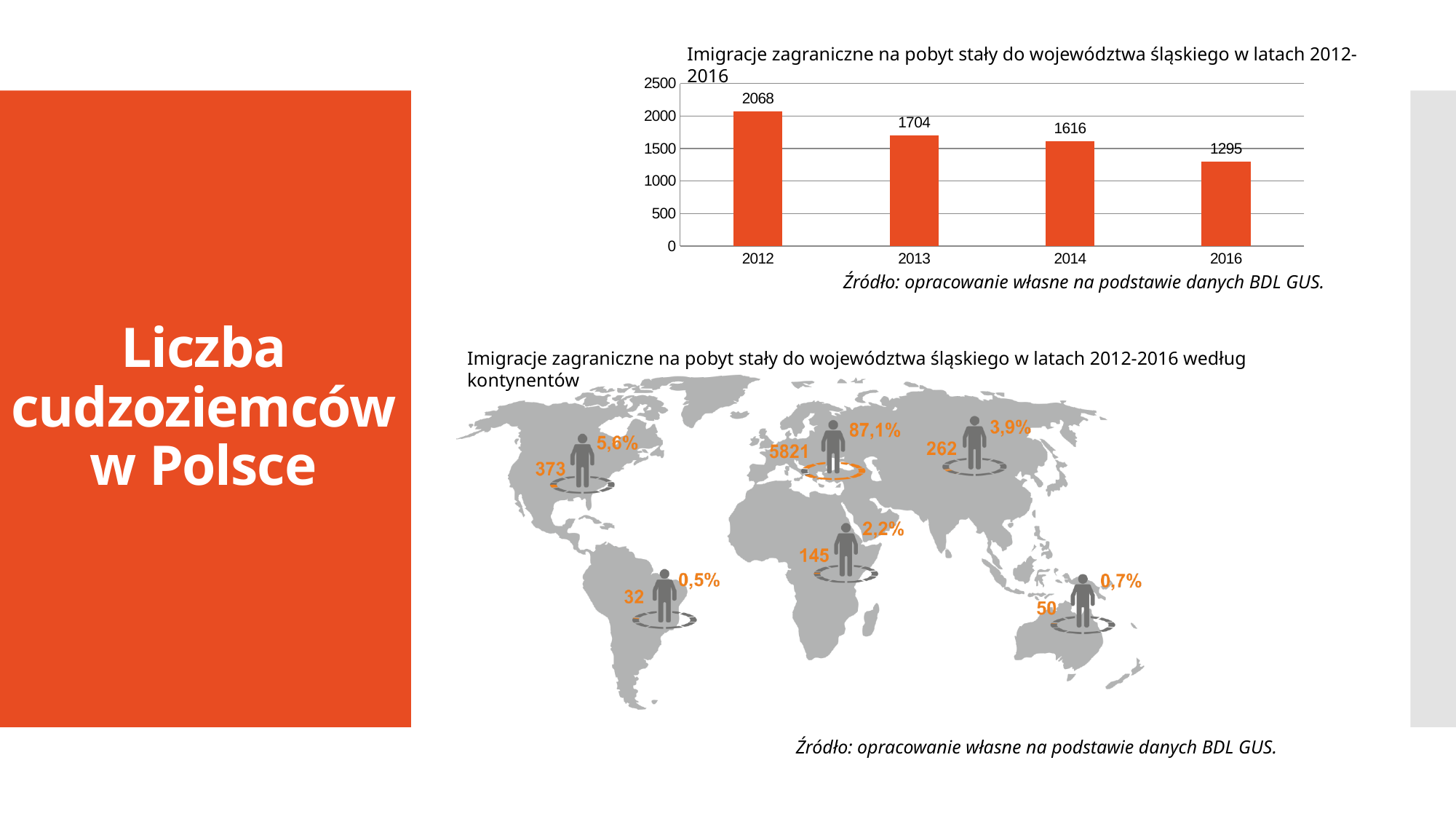
In the bar chart at the top of the slide, what is the value for 2014? 1616 In the bar chart at the top of the slide, which year has the lowest value? 2016 In the bar chart at the top of the slide, what is the difference between the values for 2012 and 2016? 773 In the bar chart at the top of the slide, do the values rise or fall from 2012 to 2016? fall In the bar chart at the top of the slide, what is the value for 2016? 1295 What kind of chart is shown at the top of the slide? bar chart In the bar chart at the top of the slide, how many years are shown on the x axis? 4 In the map infographic at the bottom of the slide, what number and percentage are shown for the figure placed over Europe? 5821, 87,1% In the bar chart at the top of the slide, which is larger, the value for 2013 or the value for 2014? 2013 In the bar chart at the top of the slide, what is the value for 2013? 1704 In the bar chart at the top of the slide, which year has the highest value? 2012 In the bar chart at the top of the slide, what is the value for 2012? 2068